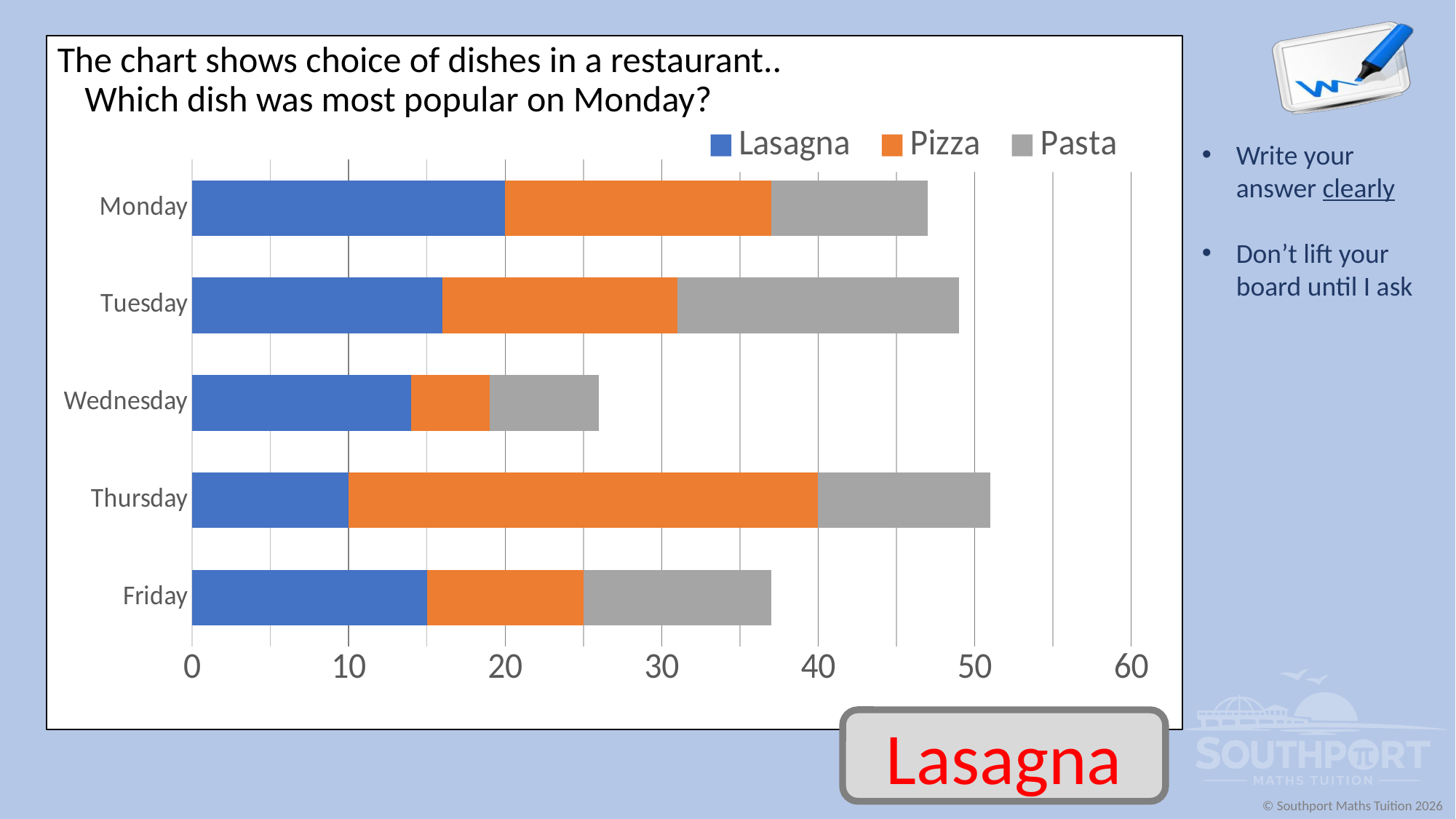
Which day has the shortest total bar? Wednesday On which day was Lasagna lowest? Thursday How many days are shown on the chart? 5 How many series does the legend list? 3 Which dishes are listed in the legend? Lasagna, Pizza, Pasta What is the value for Lasagna on Monday? 20 What kind of chart is shown on the slide? bar chart What is the value for Lasagna on Thursday? 10 On Thursday, which is larger: Pizza or Pasta? Pizza On which day was Pizza highest? Thursday Is the value for Pizza on Thursday greater or less than 20? greater On which day was Lasagna highest? Monday